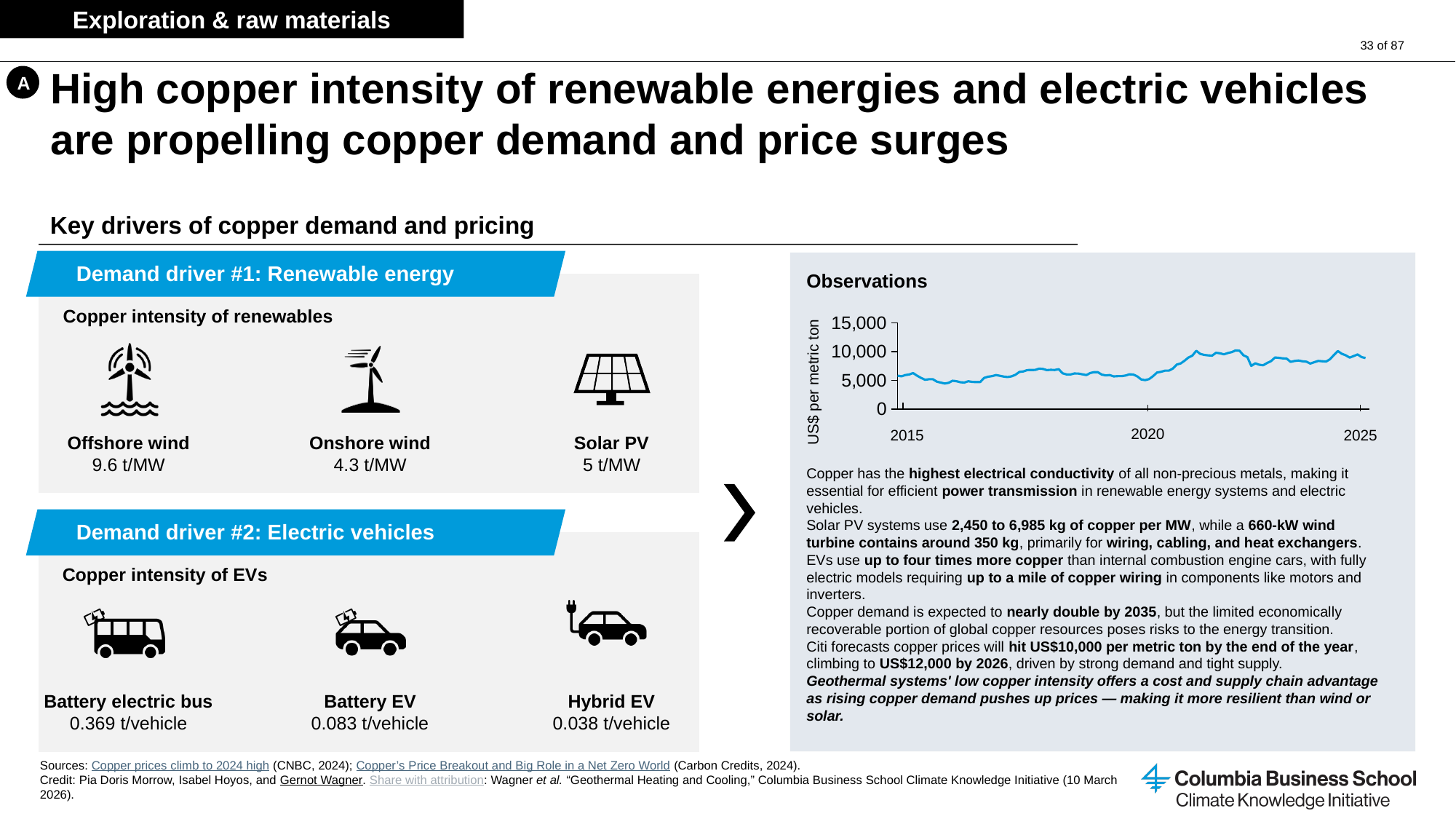
In the Observations line chart, which is larger, the value at 2020 or the value at 2025? 2025 In the Observations line chart, does the line ever reach 15,000? No In the Observations line chart, is the value at 2025 greater or less than 10,000? less In the Observations line chart, which is larger, the value at 2015 or the value at 2025? 2025 In the Observations line chart, is the value at 2020 greater or less than 10,000? less What kind of chart is shown in the Observations panel? line chart How many year labels are shown on the x-axis of the Observations line chart? 3 In the Observations line chart, do copper prices overall rise or fall from 2015 to 2025? rise What is the y-axis label of the Observations line chart? US$ per metric ton What is the highest value shown on the y-axis of the Observations line chart? 15,000